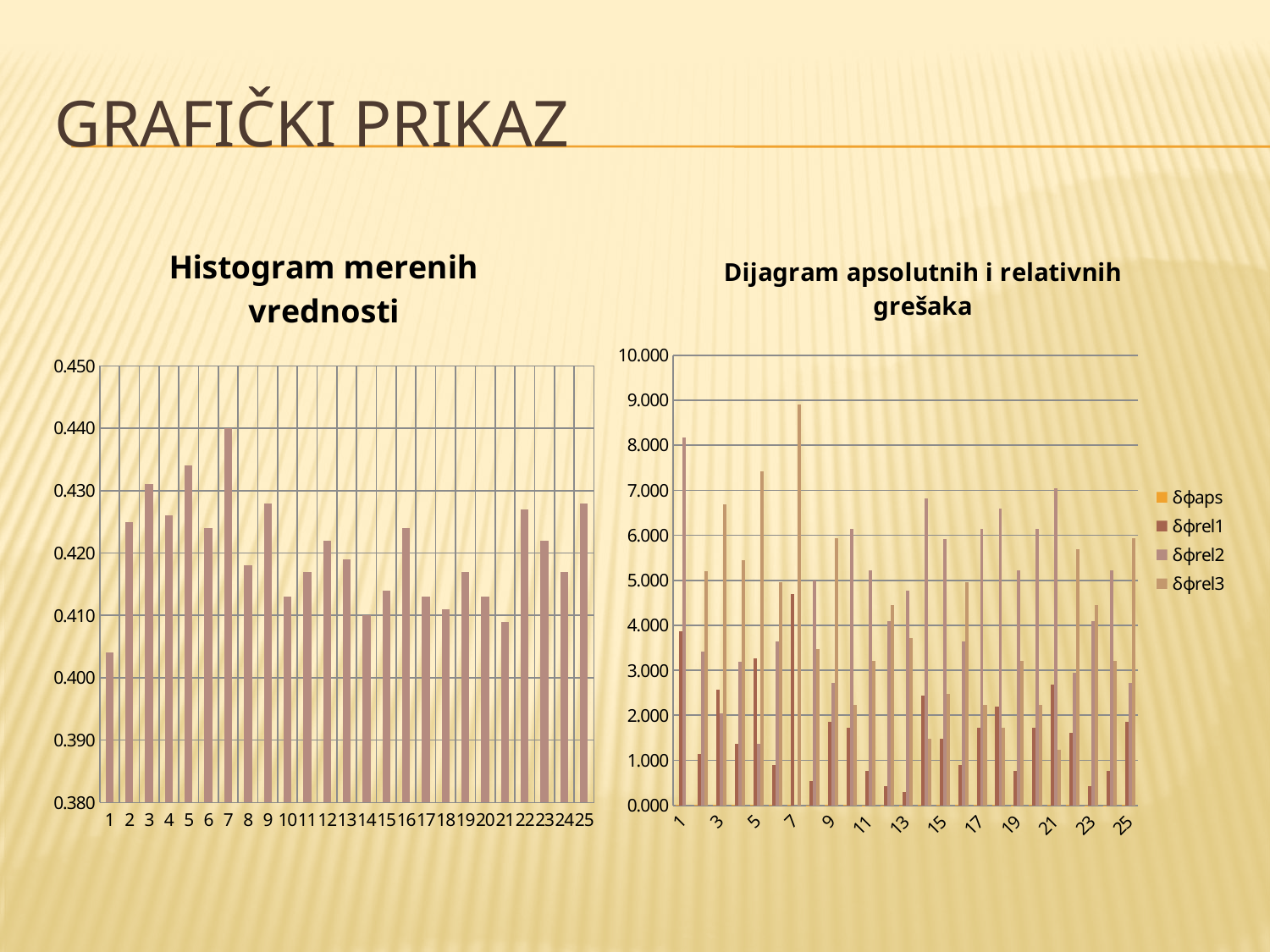
In the 'Histogram merenih vrednosti' chart, which is larger, the value for category 7 or the value for category 5? category 7 What kind of chart is the 'Histogram merenih vrednosti' chart? bar chart In the 'Histogram merenih vrednosti' chart, which category has the lowest bar? 1 In the 'Histogram merenih vrednosti' chart, is the value for category 7 greater or less than 0.430? greater How many categories are shown on the x axis of the 'Histogram merenih vrednosti' chart? 25 In the 'Dijagram apsolutnih i relativnih grešaka' chart, is the tallest bar at category 7 greater or less than 8.000? greater In the 'Histogram merenih vrednosti' chart, is the value for category 1 greater or less than 0.410? less What are the legend entries of the 'Dijagram apsolutnih i relativnih grešaka' chart? δϕaps, δϕrel1, δϕrel2, δϕrel3 What kind of chart is the 'Dijagram apsolutnih i relativnih grešaka' chart? bar chart How many series does the legend of the 'Dijagram apsolutnih i relativnih grešaka' chart list? 4 In the 'Histogram merenih vrednosti' chart, which category has the highest bar? 7